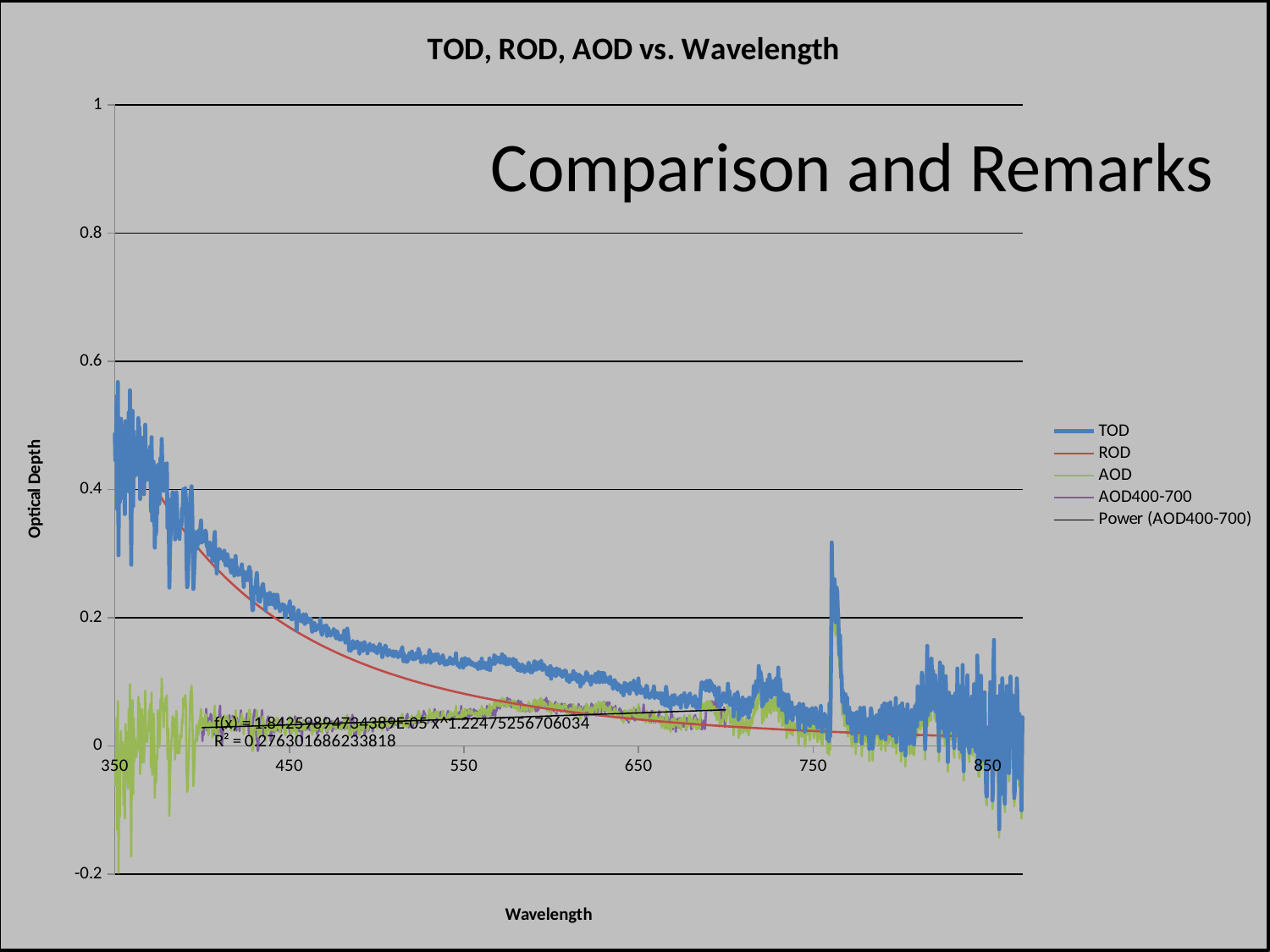
Which series is the lowest at a wavelength of 350? AOD Is the TOD value at a wavelength of 650 greater or less than 0.2? less Is the ROD value at a wavelength of 550 greater or less than 0.2? less Does the ROD series rise or fall as wavelength increases from 350 to 850? fall At a wavelength of 450, which series has the higher value, TOD or ROD? TOD At a wavelength of 550, which series has the higher value, ROD or AOD? ROD What R² value is printed for the power trendline? 0.276301686233818 How many series does the legend list? 5 Is the TOD value at a wavelength of 350 greater or less than 0.4? greater What is the label of the vertical axis? Optical Depth What kind of chart is shown on the slide? line chart What is the title of the chart? TOD, ROD, AOD vs. Wavelength